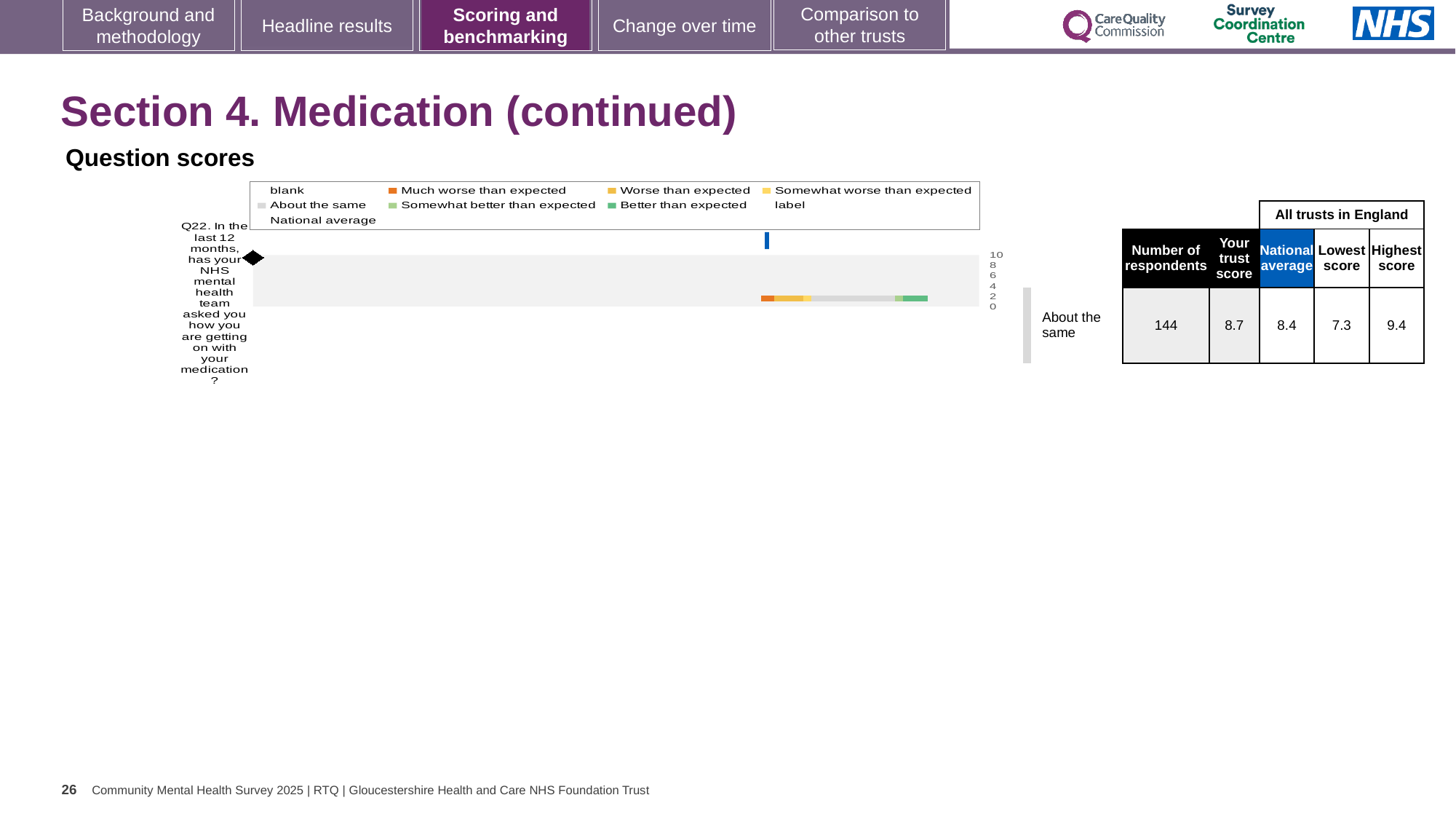
What kind of chart is used to show the Q22 question score? bar chart What benchmark category label is shown next to the Q22 bar? About the same What is the trust's score for Q22? 8.7 What is the highest score among all trusts in England for Q22? 9.4 Is the trust's score for Q22 greater or less than 8 on the chart's axis? greater What is the lowest score among all trusts in England for Q22? 7.3 For Q22, which is larger: the trust's score or the national average? the trust's score What is the difference between the highest and lowest scores for Q22 across all trusts in England? 2.1 What is the number of respondents for Q22? 144 How many survey questions are plotted in the Question scores chart? 1 What is the national average score for Q22? 8.4 Which question number is plotted in the Question scores chart? Q22